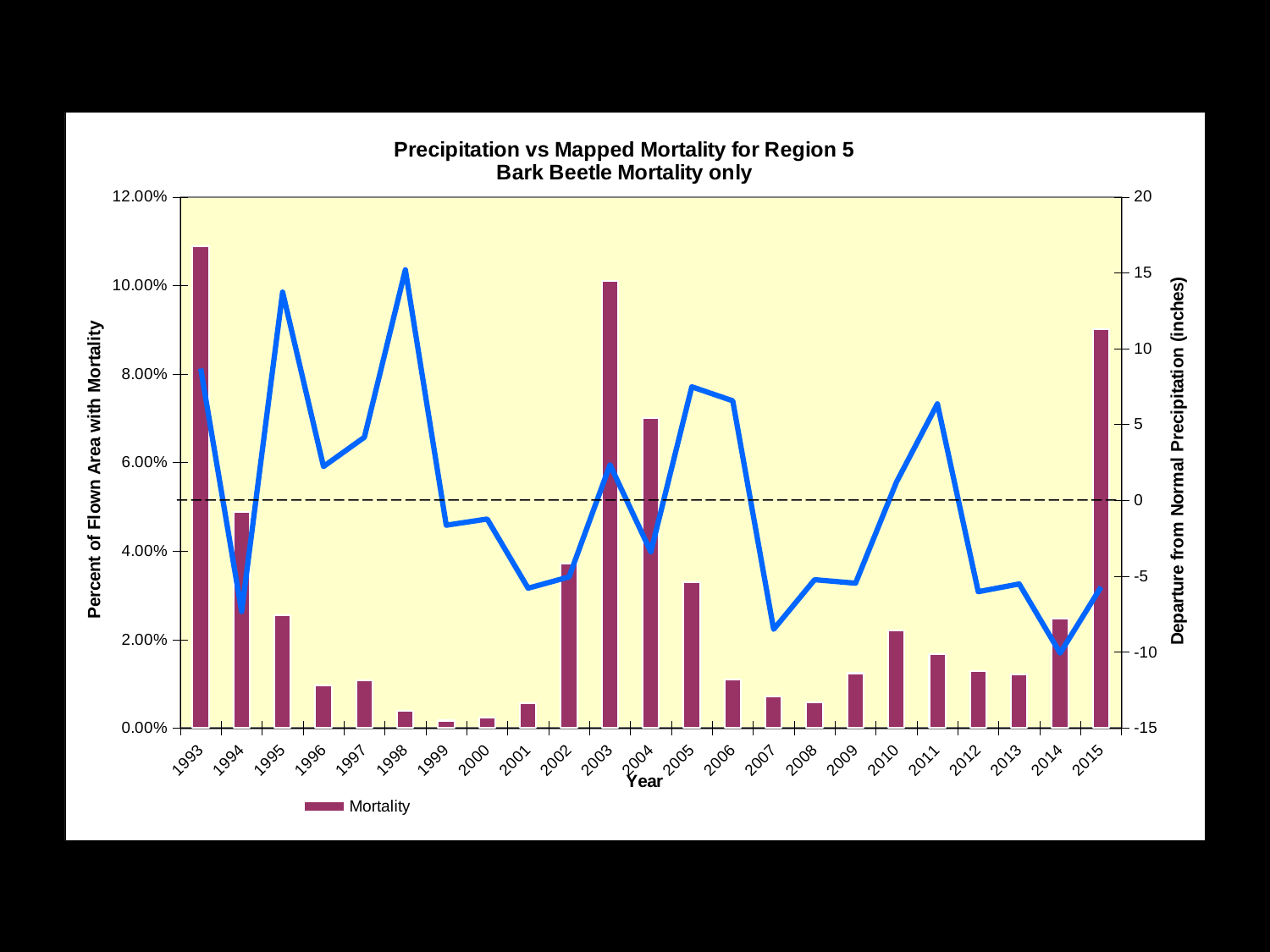
Is the Departure from Normal Precipitation for 2014 greater or less than -5 inches? less Is the Mortality value for 1993 greater or less than 10.00%? greater What is the title of the chart? Precipitation vs Mapped Mortality for Region 5 Bark Beetle Mortality only Is the Mortality value for 1996 greater or less than 2.00%? less Which year has the highest Mortality bar? 1993 Do the Mortality bars rise or fall from 2005 to 2008? fall How many series does the legend list? 1 How many years are shown on the x axis? 23 Which year has the larger Mortality bar, 2003 or 2004? 2003 What kind of chart is shown on the slide? A combination bar and line chart